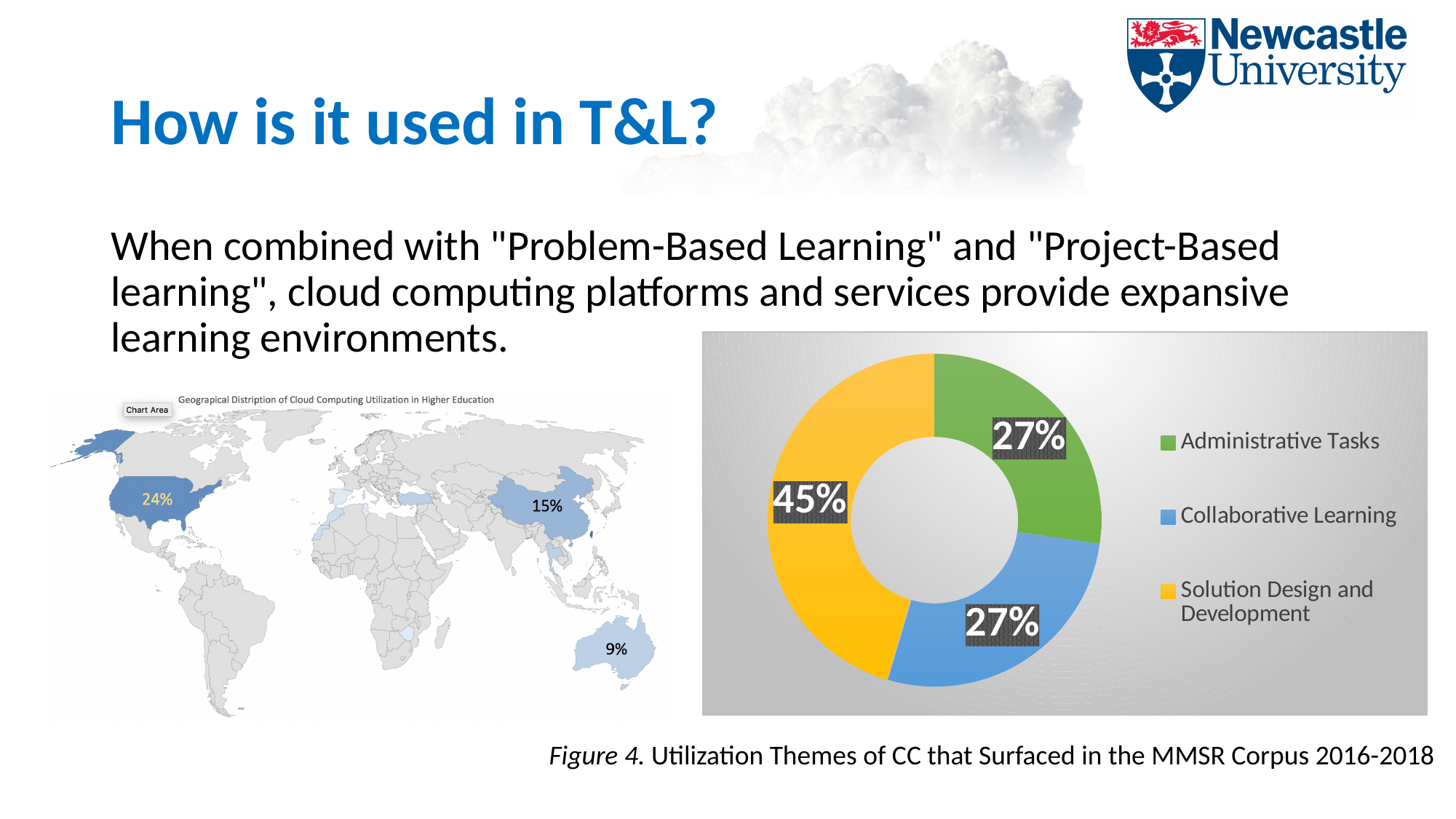
In the doughnut chart on the right, which theme has the largest share? Solution Design and Development In the map chart on the left, what is the difference between the percentage labelled on the United States and the percentage labelled on Australia? 15% What kind of chart is the chart on the right of the slide? Doughnut chart In the map chart on the left, what percentage is labelled on China? 15% In the map chart on the left, what percentage is labelled on Australia? 9% In the doughnut chart on the right, what is the difference between the share for Solution Design and Development and the share for Administrative Tasks? 18% In the doughnut chart on the right, which colour represents Collaborative Learning? Blue In the doughnut chart on the right, what share is labelled for Solution Design and Development? 45% In the map chart on the left, what percentage is labelled on the United States? 24% In the doughnut chart on the right, what share is labelled for Collaborative Learning? 27% In the doughnut chart on the right, how many entries does the legend list? 3 In the doughnut chart on the right, what share is labelled for Administrative Tasks? 27%